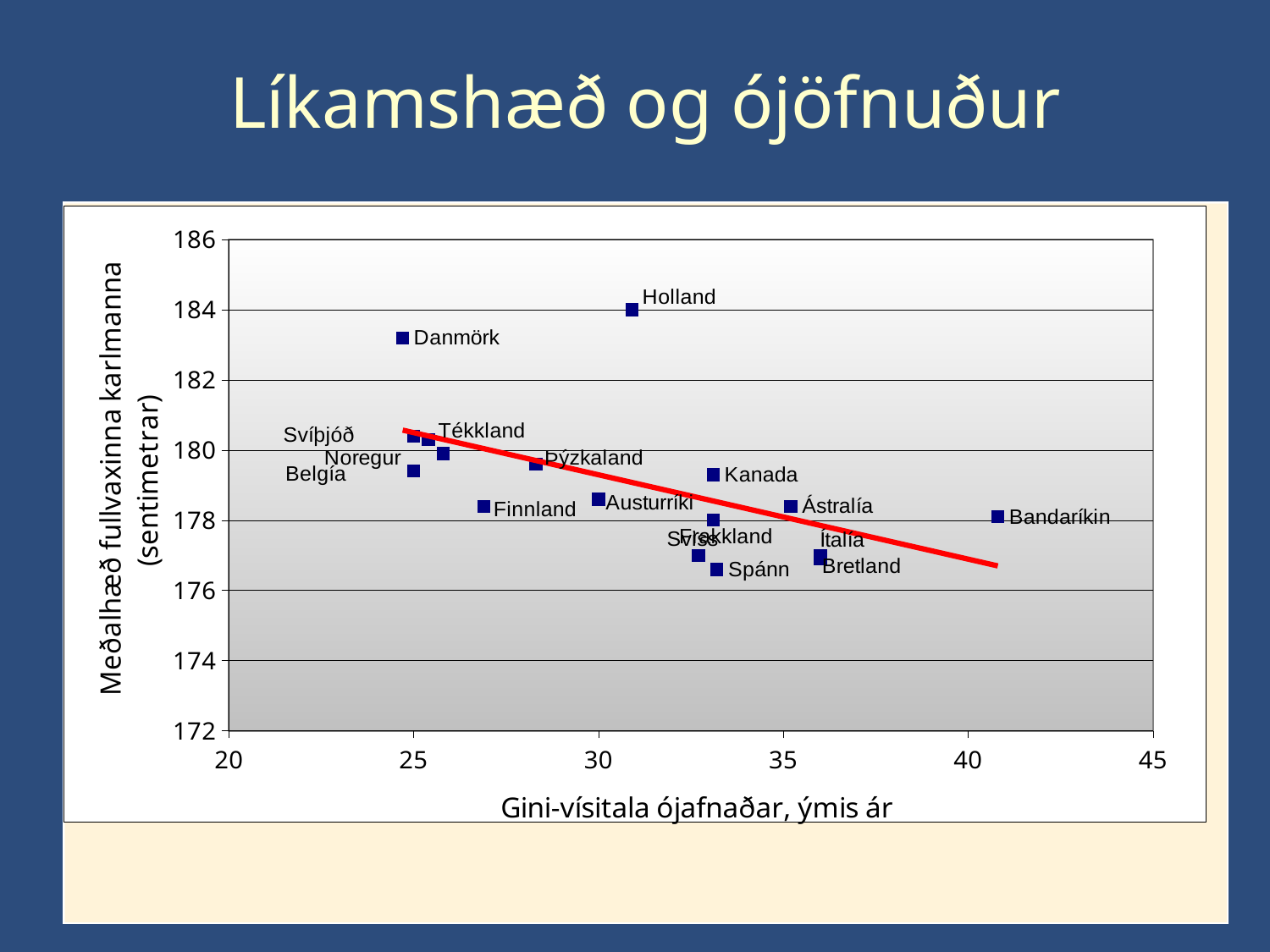
What is the title of the chart on the slide? Líkamshæð og ójöfnuður According to the trend line, does average male height rise or fall as the Gini index increases? Fall Is the average male height for Holland greater or less than 182? greater Which has a greater average male height, Holland or Danmörk? Holland What kind of chart is shown on the slide? Scatter chart Which country has the highest average male height in the chart? Holland Which country has the highest Gini index value in the chart? Bandaríkin Is the Gini index value for Bandaríkin greater or less than 40? greater Is the Gini index value for Kanada greater or less than 30? greater Which country has the lowest average male height in the chart? Spánn What is the label of the x axis? Gini-vísitala ójafnaðar, ýmis ár